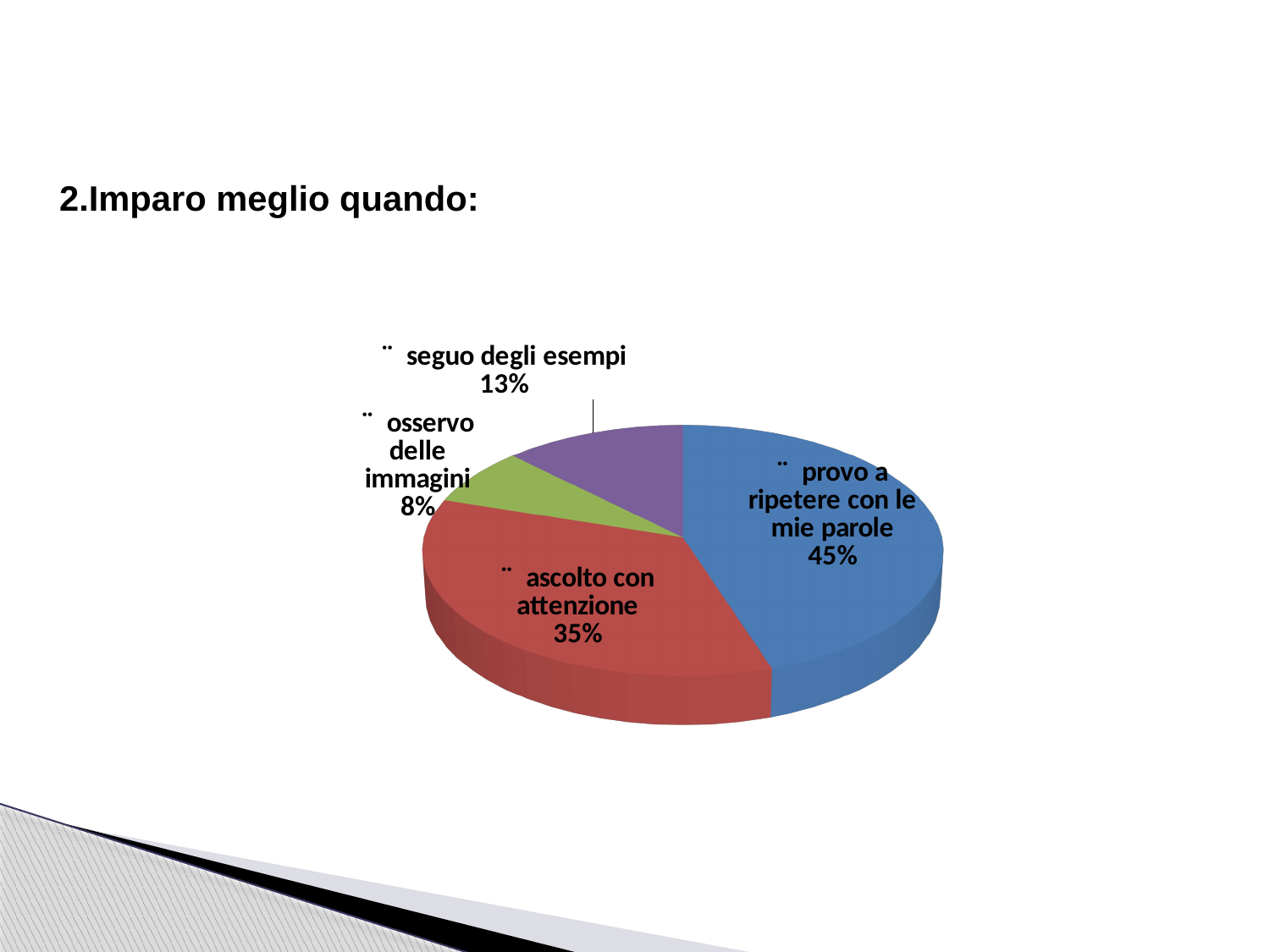
What share of the pie does "ascolto con attenzione" have? 35% How many slices does the pie chart have? 4 Which slice of the pie is the largest? provo a ripetere con le mie parole What share of the pie does "provo a ripetere con le mie parole" have? 45% What share of the pie does "osservo delle immagini" have? 8% Which slice of the pie is the smallest? osservo delle immagini Which is larger: "seguo degli esempi" or "osservo delle immagini"? seguo degli esempi What colour is the slice for "ascolto con attenzione"? red What kind of chart is shown on the slide? pie chart What is the difference in percentage points between "provo a ripetere con le mie parole" and "ascolto con attenzione"? 10 What is the title shown above the chart? 2.Imparo meglio quando: